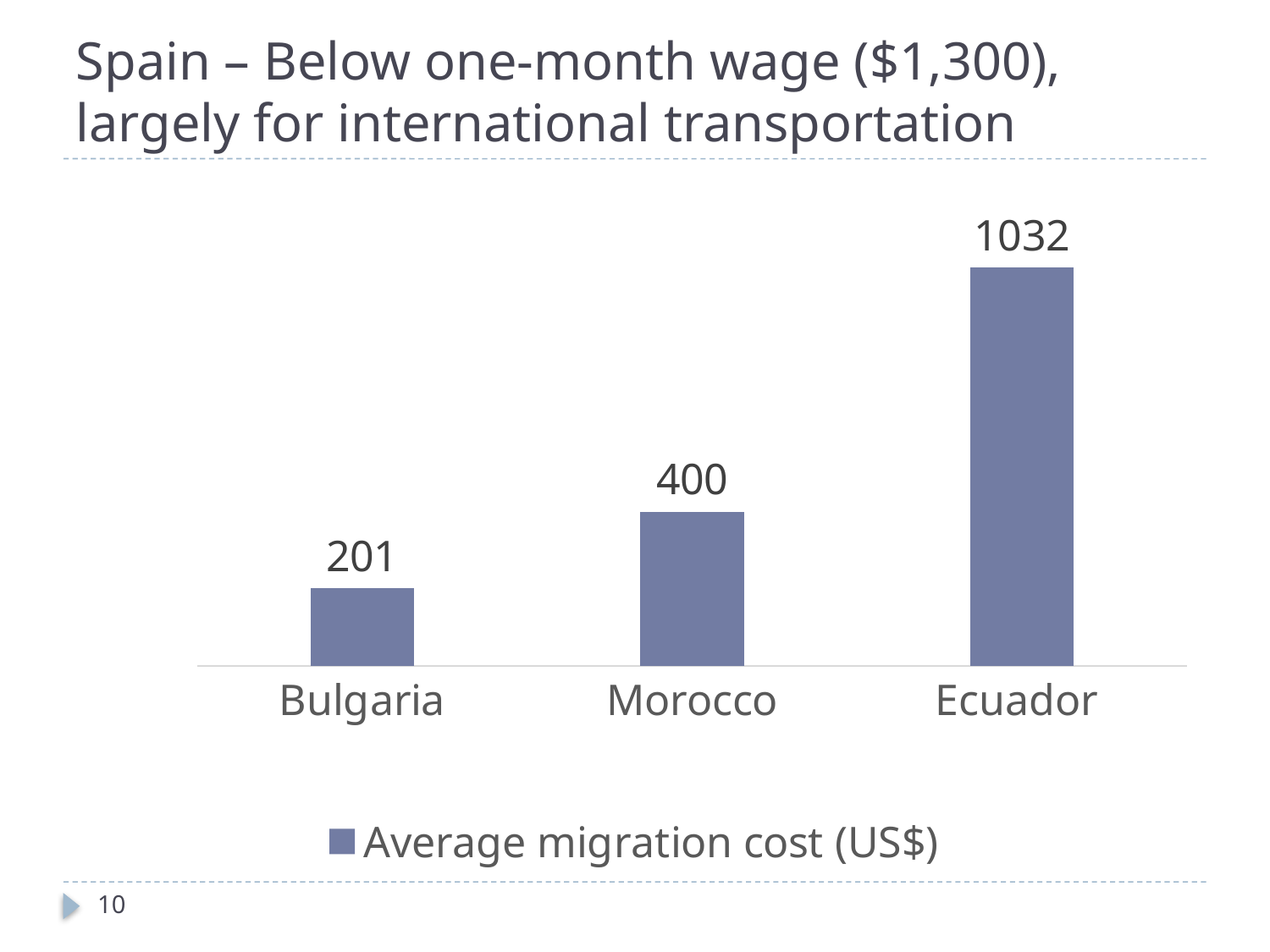
What is the difference in average migration cost between Morocco and Bulgaria? 199 How many countries are shown in the chart? 3 What is the series name shown in the legend? Average migration cost (US$) Which country has the lowest average migration cost? Bulgaria Which country has the highest average migration cost? Ecuador What is the average migration cost for Morocco? 400 What is the average migration cost for Bulgaria? 201 Which has a higher average migration cost, Bulgaria or Morocco? Morocco What is the difference in average migration cost between Ecuador and Morocco? 632 What kind of chart is shown on the slide? Bar chart What is the average migration cost for Ecuador? 1032 How many series does the legend list? 1